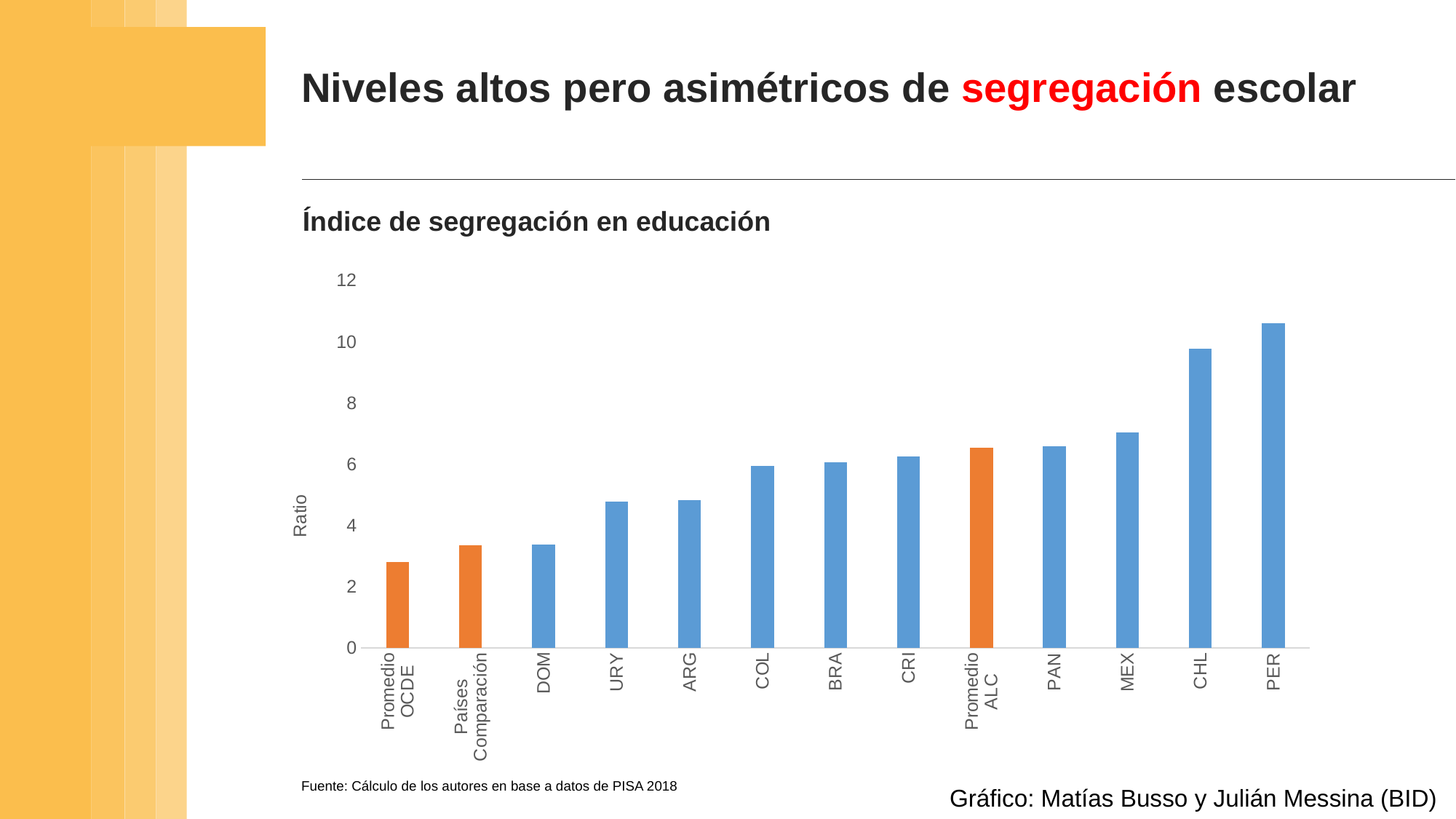
Which is larger, the value for MEX or the value for PAN? MEX How many categories are plotted on the x axis of the chart? 13 Is the value for CHL greater or less than 8? greater Is the value for MEX greater or less than 6? greater What is the label on the vertical axis of the chart? Ratio Which is larger, the value for Promedio ALC or the value for Promedio OCDE? Promedio ALC Do the bar values rise or fall moving from left to right along the x axis? rise Is the value for PER greater or less than 10? greater Which category has the highest segregation index in the chart? PER Which category has the lowest segregation index in the chart? Promedio OCDE What kind of chart is shown on the slide? bar chart